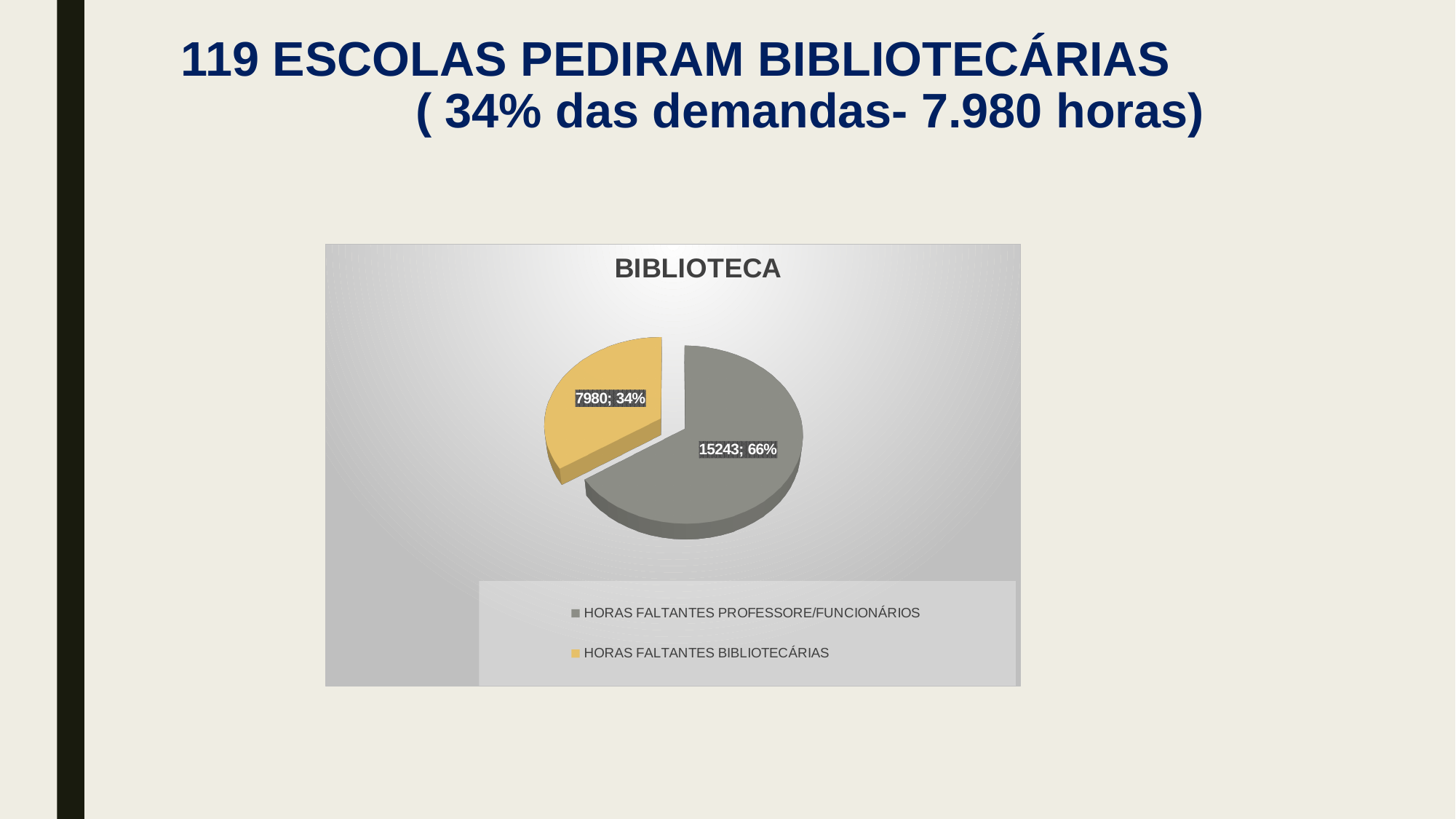
What share of the pie does HORAS FALTANTES PROFESSORE/FUNCIONÁRIOS represent? 66% What is the value for HORAS FALTANTES BIBLIOTECÁRIAS? 7980 What share of the pie does HORAS FALTANTES BIBLIOTECÁRIAS represent? 34% What is the value for HORAS FALTANTES PROFESSORE/FUNCIONÁRIOS? 15243 Which colour represents HORAS FALTANTES BIBLIOTECÁRIAS in the chart? yellow What is the difference between the values for HORAS FALTANTES PROFESSORE/FUNCIONÁRIOS and HORAS FALTANTES BIBLIOTECÁRIAS? 7263 How many entries does the legend list? 2 How many slices does the pie chart have? 2 What is the title of the chart? BIBLIOTECA Which slice is the largest? HORAS FALTANTES PROFESSORE/FUNCIONÁRIOS Which slice is the smallest? HORAS FALTANTES BIBLIOTECÁRIAS What kind of chart is shown on the slide? pie chart